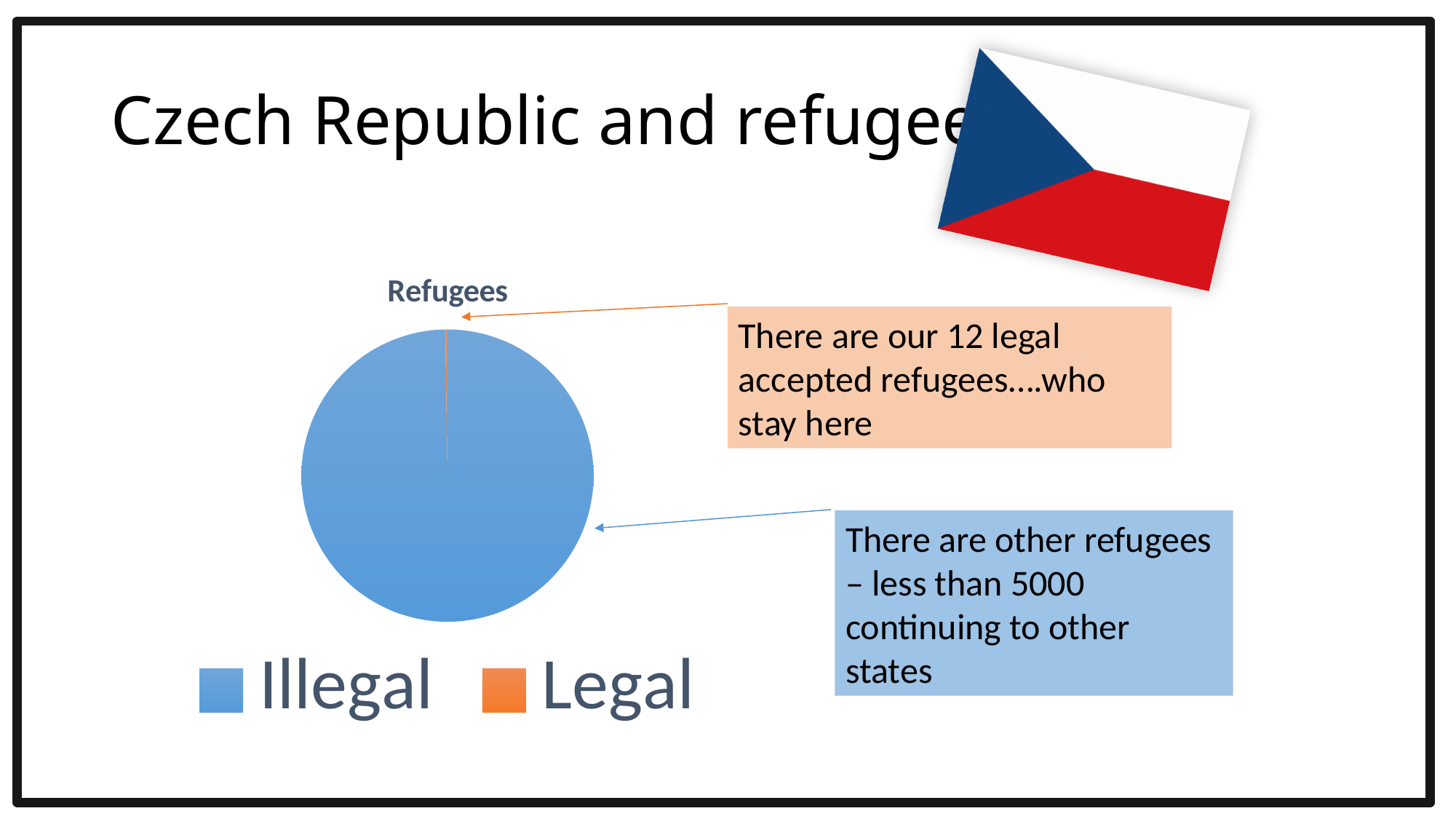
What kind of chart is shown on the slide? Pie chart How many entries does the chart legend list? 2 Which is larger in the pie chart, Illegal or Legal? Illegal What colour represents the Legal category in the pie chart? Orange What is the title of the chart? Refugees Which category takes up the smallest share of the pie? Legal How many categories does the pie chart have? 2 Which category takes up the largest share of the pie? Illegal